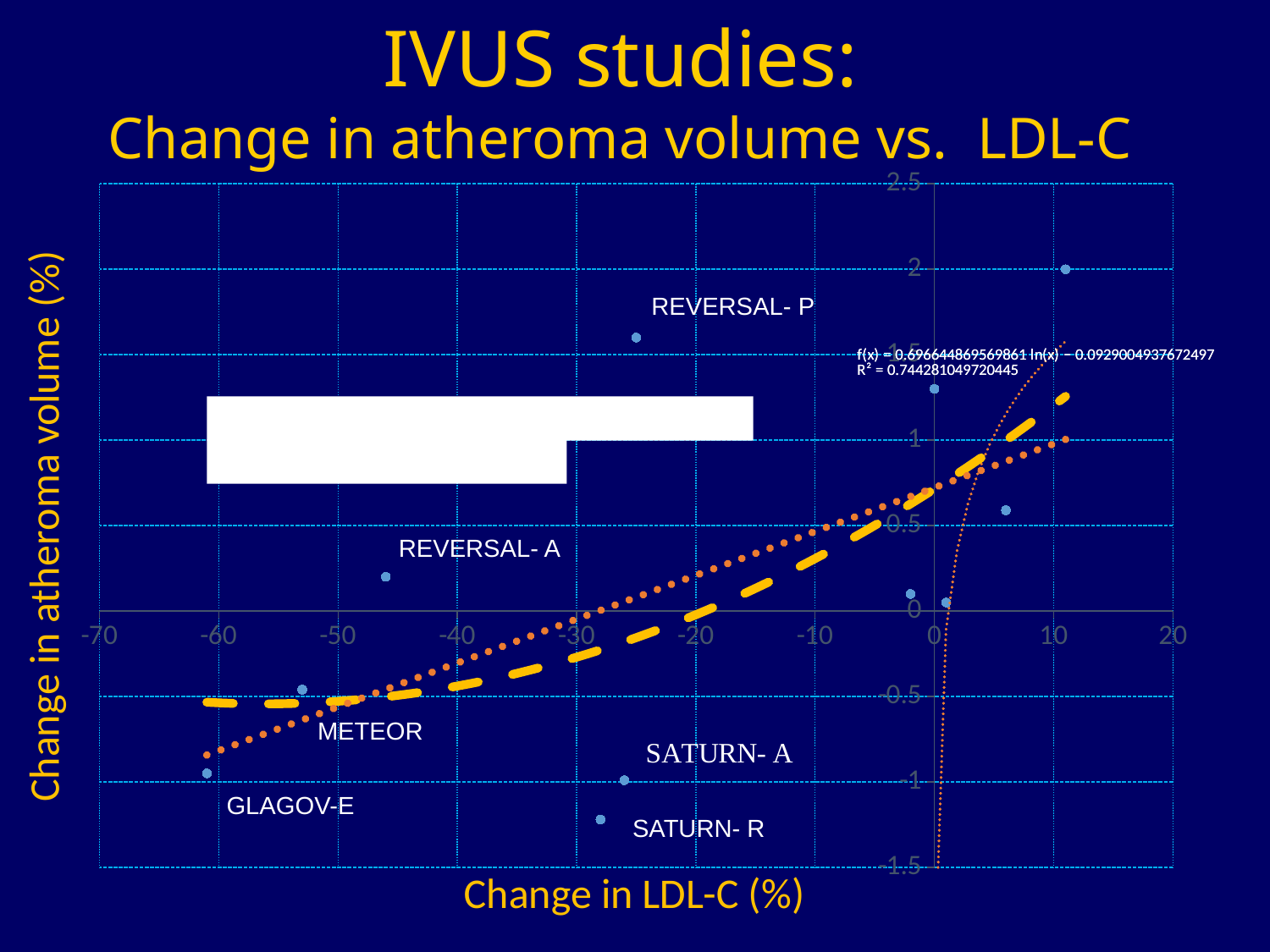
Is the change in LDL-C for GLAGOV-E greater or less than -50? less Do the fitted trend lines rise or fall as the change in LDL-C increases from left to right? rise What is the title of the x axis? Change in LDL-C (%) Which labeled study has the lowest change in atheroma volume? SATURN-R Is the change in atheroma volume for GLAGOV-E greater or less than -0.5? less What type of chart is shown on the slide? scatter chart Is the change in atheroma volume for REVERSAL-P greater or less than 1? greater Which labeled study has the highest change in atheroma volume? REVERSAL-P Which has a higher change in atheroma volume, METEOR or GLAGOV-E? METEOR